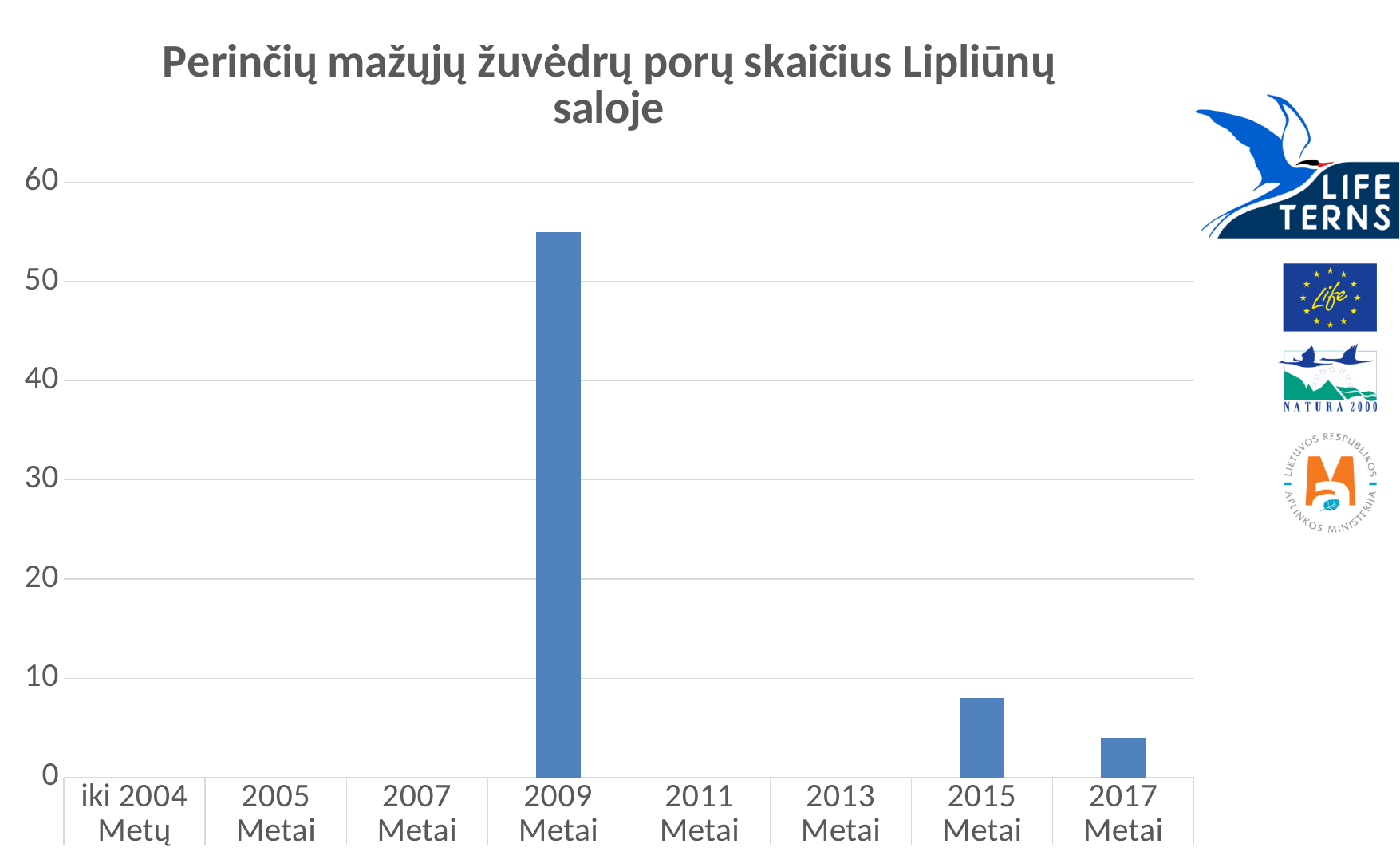
Which category has the highest value in the chart? 2009 Metai What kind of chart is shown on the slide? bar chart What is the title of the chart? Perinčių mažųjų žuvėdrų porų skaičius Lipliūnų saloje Is the value for 2009 Metai greater or less than 60? less Which is larger, the value for 2015 Metai or the value for 2017 Metai? 2015 Metai Do the values rise or fall from 2009 Metai to 2017 Metai? fall Which is larger, the value for 2009 Metai or the value for 2015 Metai? 2009 Metai Is the value for 2015 Metai greater or less than 10? less Is the value for 2017 Metai greater or less than 10? less How many categories are shown on the x axis of the chart? 8 How many categories in the chart have a visible bar? 3